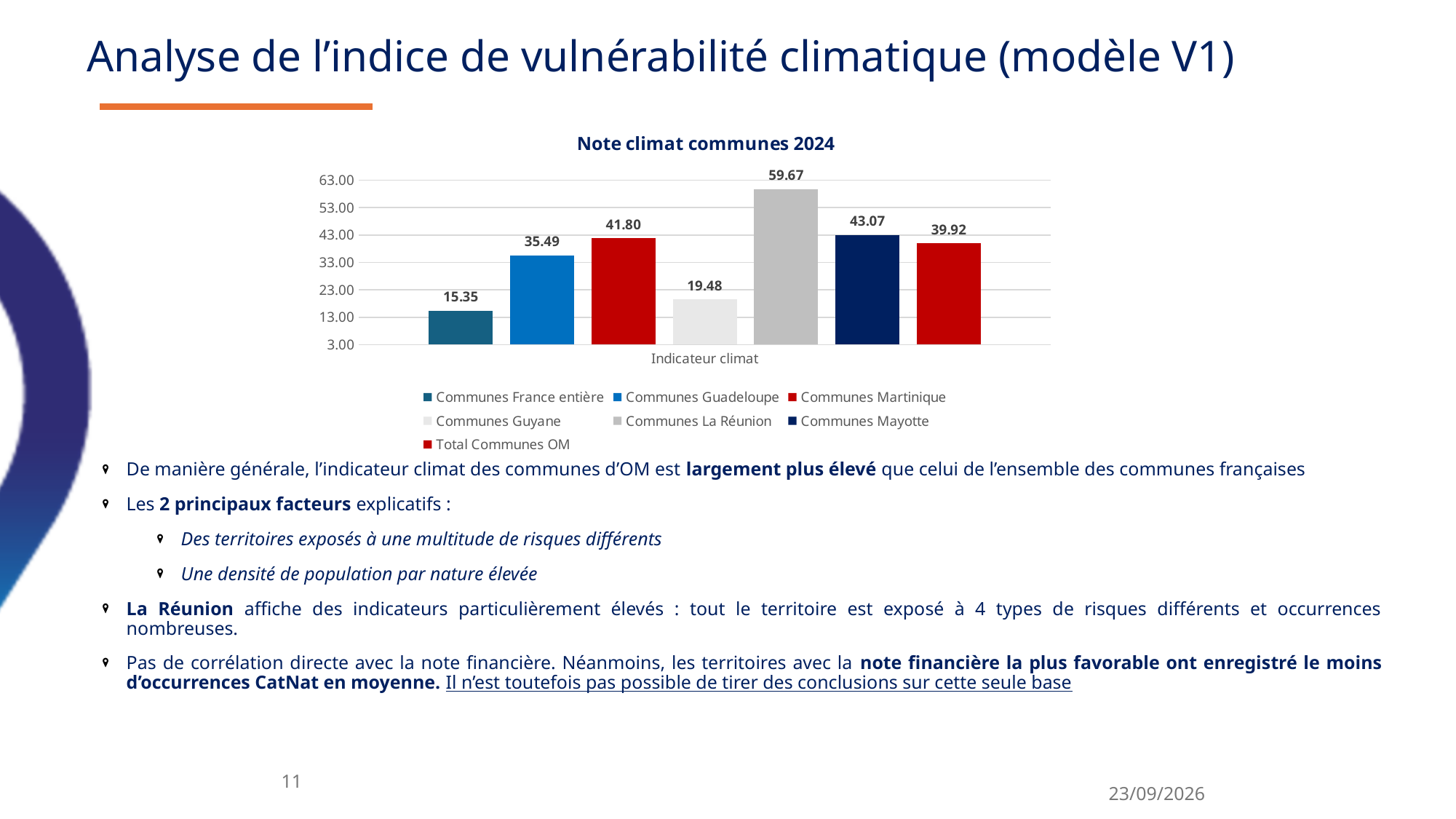
What is the value for Communes La Réunion? 59.67 What is the difference between the values for Communes La Réunion and Communes France entière? 44.32 How many series does the chart legend list? 7 What is the value for Communes Guyane? 19.48 Which series has the highest value? Communes La Réunion What kind of chart is shown on the slide? Bar chart What is the value for Total Communes OM? 39.92 Which is larger, the value for Communes Mayotte or the value for Communes Martinique? Communes Mayotte What is the title of the chart? Note climat communes 2024 What is the value for Communes France entière? 15.35 What is the label on the x axis category? Indicateur climat Which series has the lowest value? Communes France entière